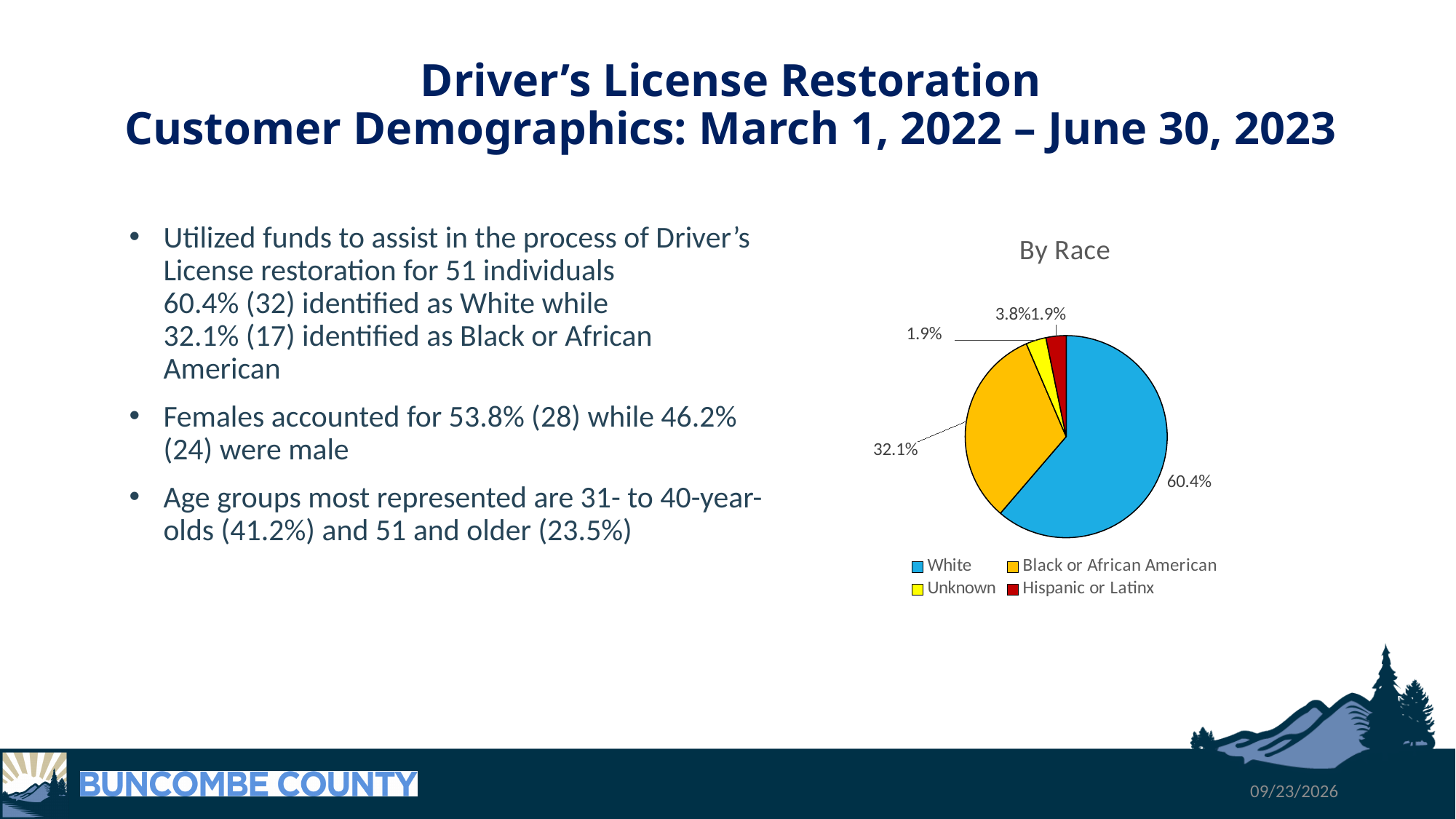
Which category has the largest slice of the pie? White What kind of chart is shown on the slide? pie chart What is the title of the chart? By Race How many categories does the legend list? 4 What share of the pie is White? 60.4% What colour is the Black or African American slice? orange Which is larger, the White slice or the Black or African American slice? White What is the difference in percentage points between the White slice and the Black or African American slice? 28.3 What share of the pie is Black or African American? 32.1%